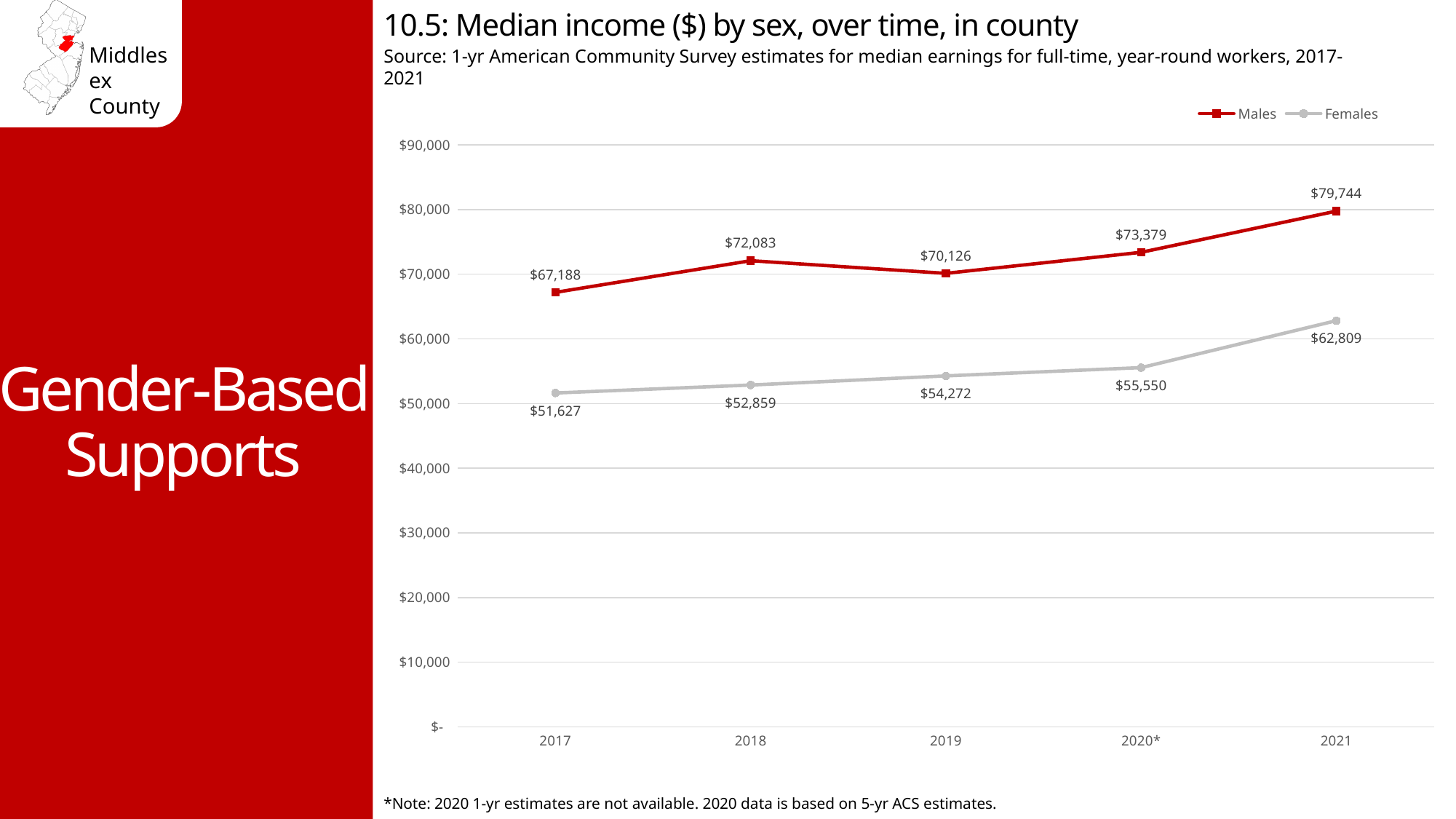
What is the median income for Males in 2019? $70,126 Is the Females median income in 2019 greater or less than $60,000? less In which year is the Females median income lowest? 2017 In which year is the Males median income highest? 2021 What kind of chart is shown on the slide? line chart What is the median income for Females in 2020*? $55,550 Which is larger, the Males median income in 2018 or in 2019? 2018 What is the median income for Females in 2017? $51,627 What is the difference between the Males and Females median income in 2021? $16,935 How many series does the legend list? 2 How many years are shown on the x axis? 5 What is the median income for Males in 2021? $79,744